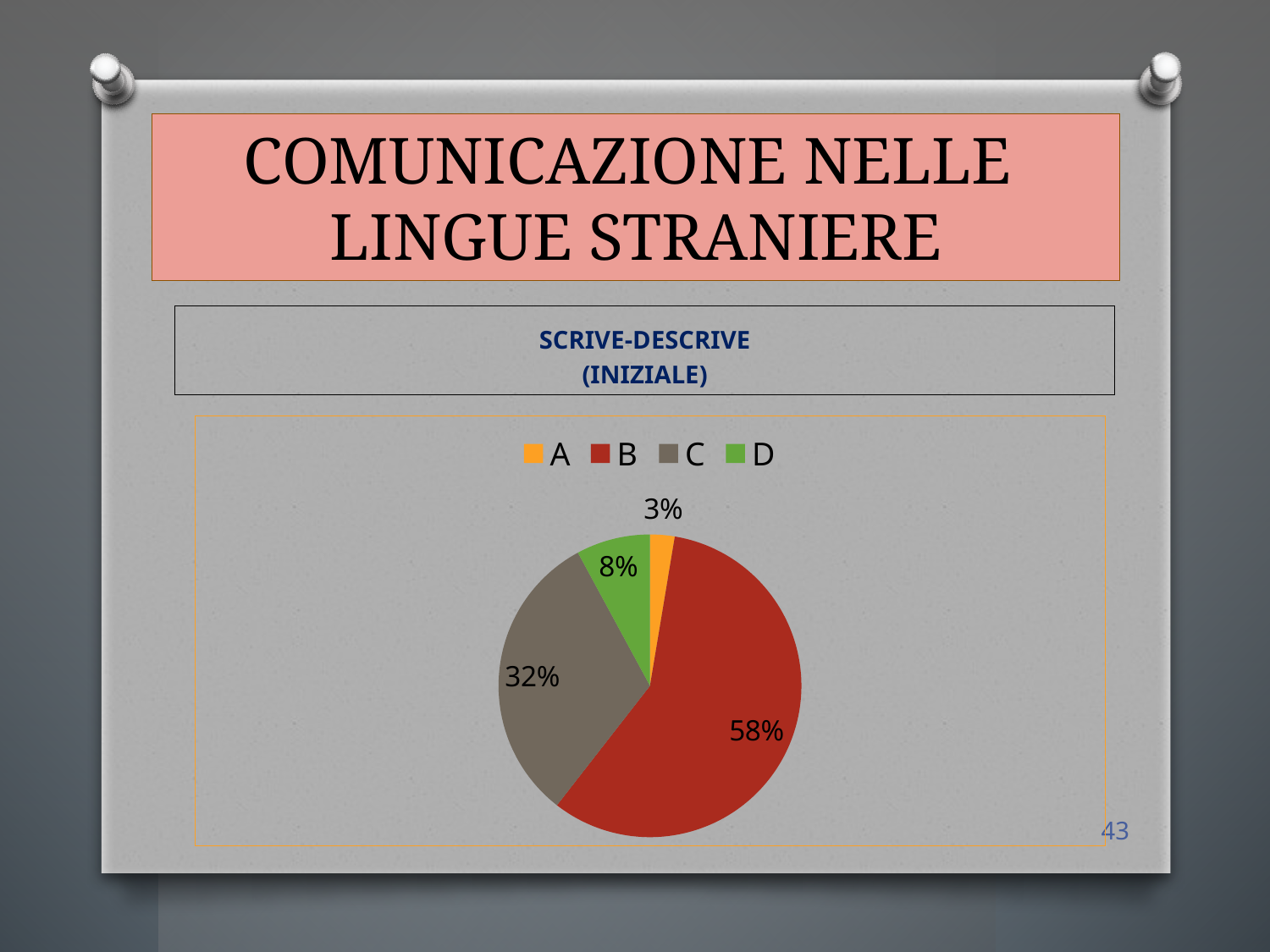
What colour is the slice for category B? red What share of the pie does category C have? 32% How many categories does the legend list? 4 Which is larger, the slice for C or the slice for D? C What kind of chart is shown on the slide? pie chart What is the difference in percentage points between category B and category C? 26 What share of the pie does category A have? 3% What share of the pie does category B have? 58% Which category has the smallest slice of the pie? A What is the title shown above the chart? SCRIVE-DESCRIVE (INIZIALE) Which category has the largest slice of the pie? B